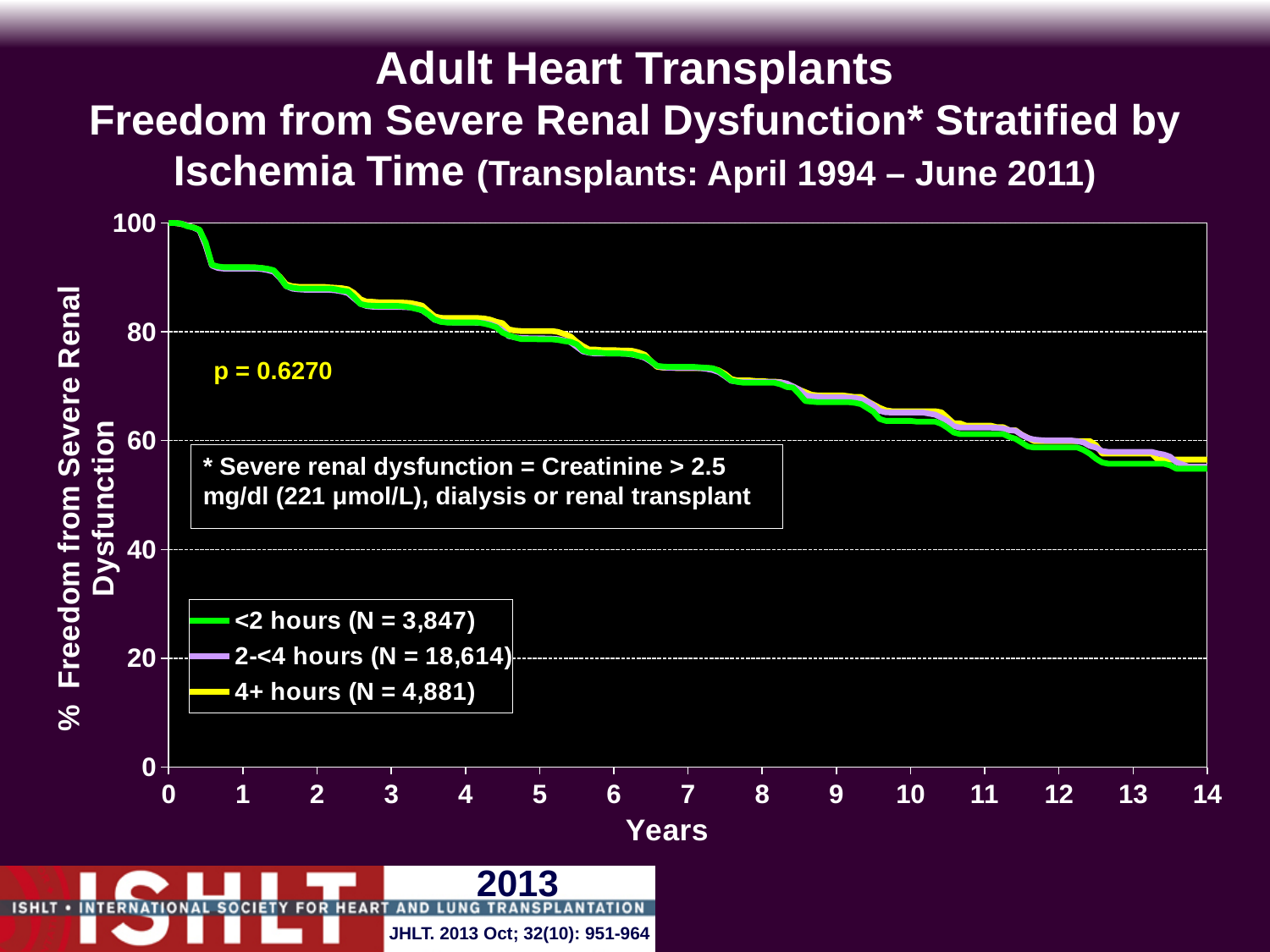
Is the value for the 4+ hours group at year 10 greater or less than 60? greater What is the highest tick value shown on the x axis? 14 What is the label of the x axis? Years How many series does the legend list? 3 Is the value for the <2 hours group at year 8 greater or less than 80? less What is the p-value shown on the chart? p = 0.6270 Is the value for the <2 hours group at year 14 greater or less than 60? less What kind of chart is shown on the slide? line chart What is the value of the curves at year 0? 100 Do the curves rise or fall as the years increase along the x axis? fall